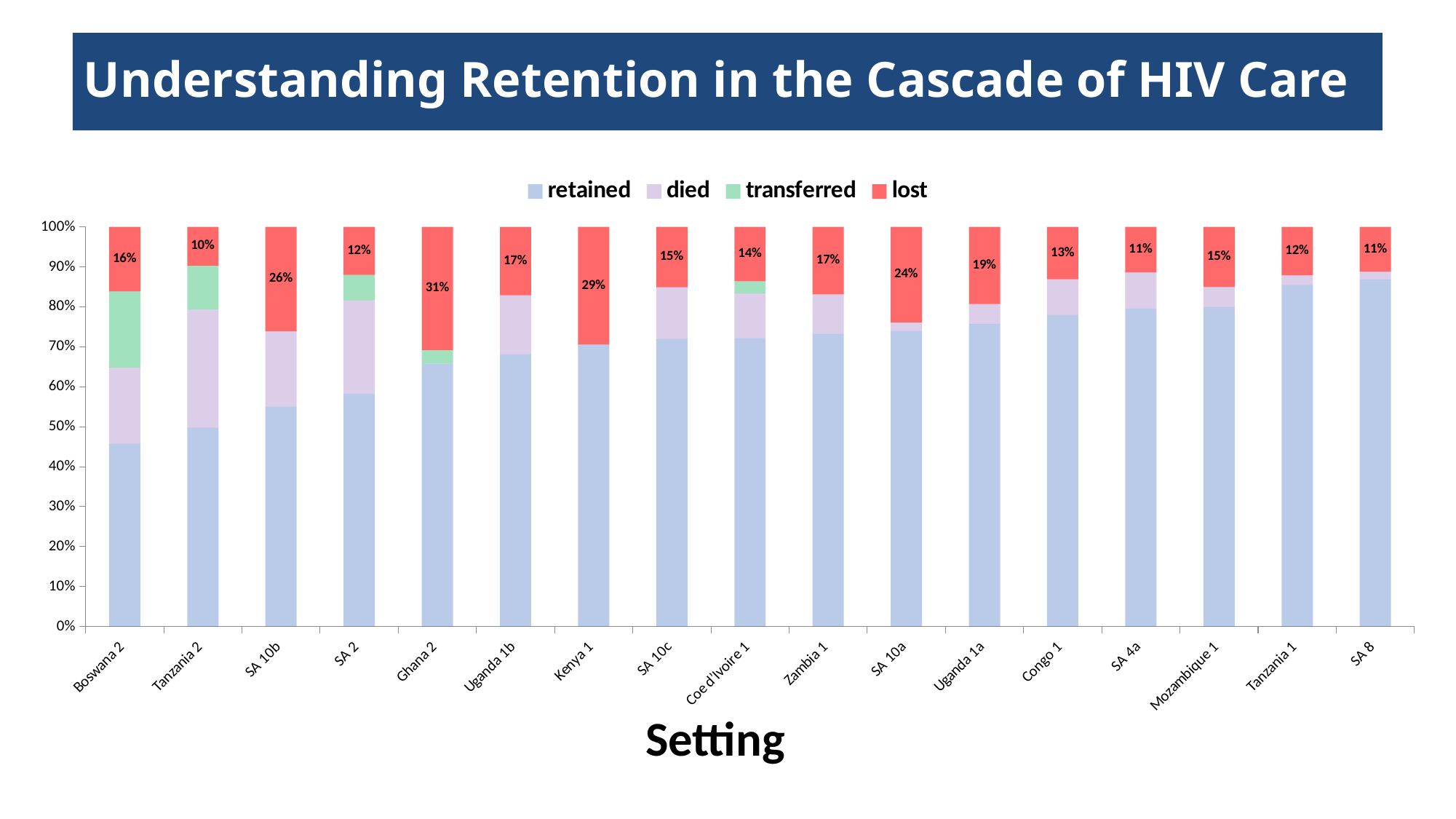
How many settings are shown on the x axis? 17 Which setting has the lowest lost percentage? Tanzania 2 Does the retained share rise or fall moving left to right along the x axis? rise What is the lost percentage for Tanzania 2? 10% What is the lost percentage for Ghana 2? 31% What is the lost percentage for SA 10b? 26% How many series does the legend list? 4 Which has a larger lost percentage, SA 10a or Uganda 1a? SA 10a Is the retained value for Boswana 2 greater or less than 50%? less Which setting has the highest lost percentage? Ghana 2 What is the difference between the lost percentage for Kenya 1 and for Congo 1? 16% Is the retained value for SA 8 greater or less than 80%? greater